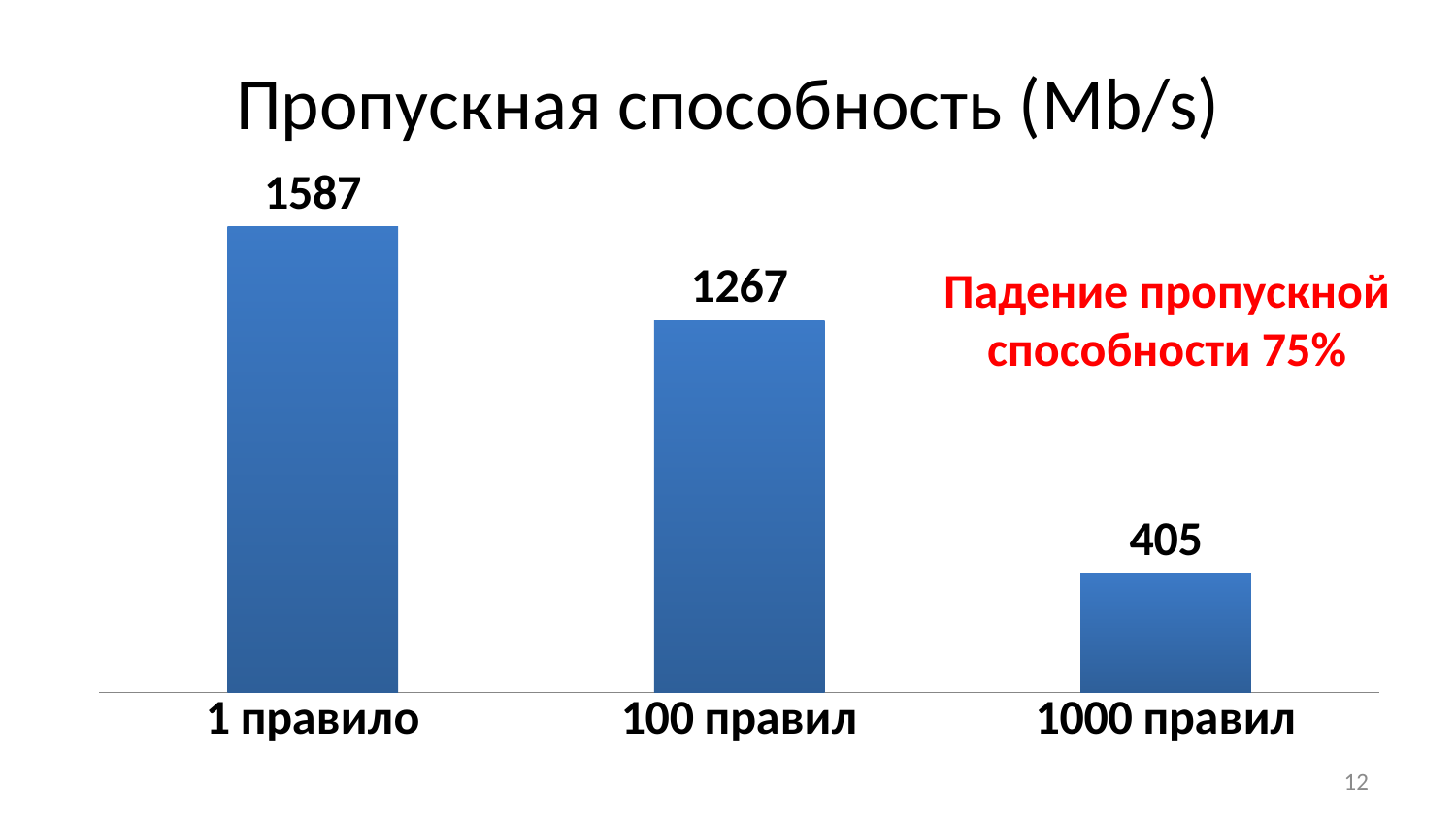
Which category has the highest value? 1 правило What is the value for "100 правил"? 1267 What is the value for "1000 правил"? 405 Do the values rise or fall from left to right along the x axis? Fall What is the difference between the values for "1 правило" and "1000 правил"? 1182 Which category has the lowest value? 1000 правил What kind of chart is shown on the slide? Bar chart What is the value for "1 правило"? 1587 How many categories are shown in the chart? 3 Which is larger, the value for "100 правил" or the value for "1000 правил"? 100 правил What is the difference between the values for "1 правило" and "100 правил"? 320 What is the title of the chart? Пропускная способность (Mb/s)